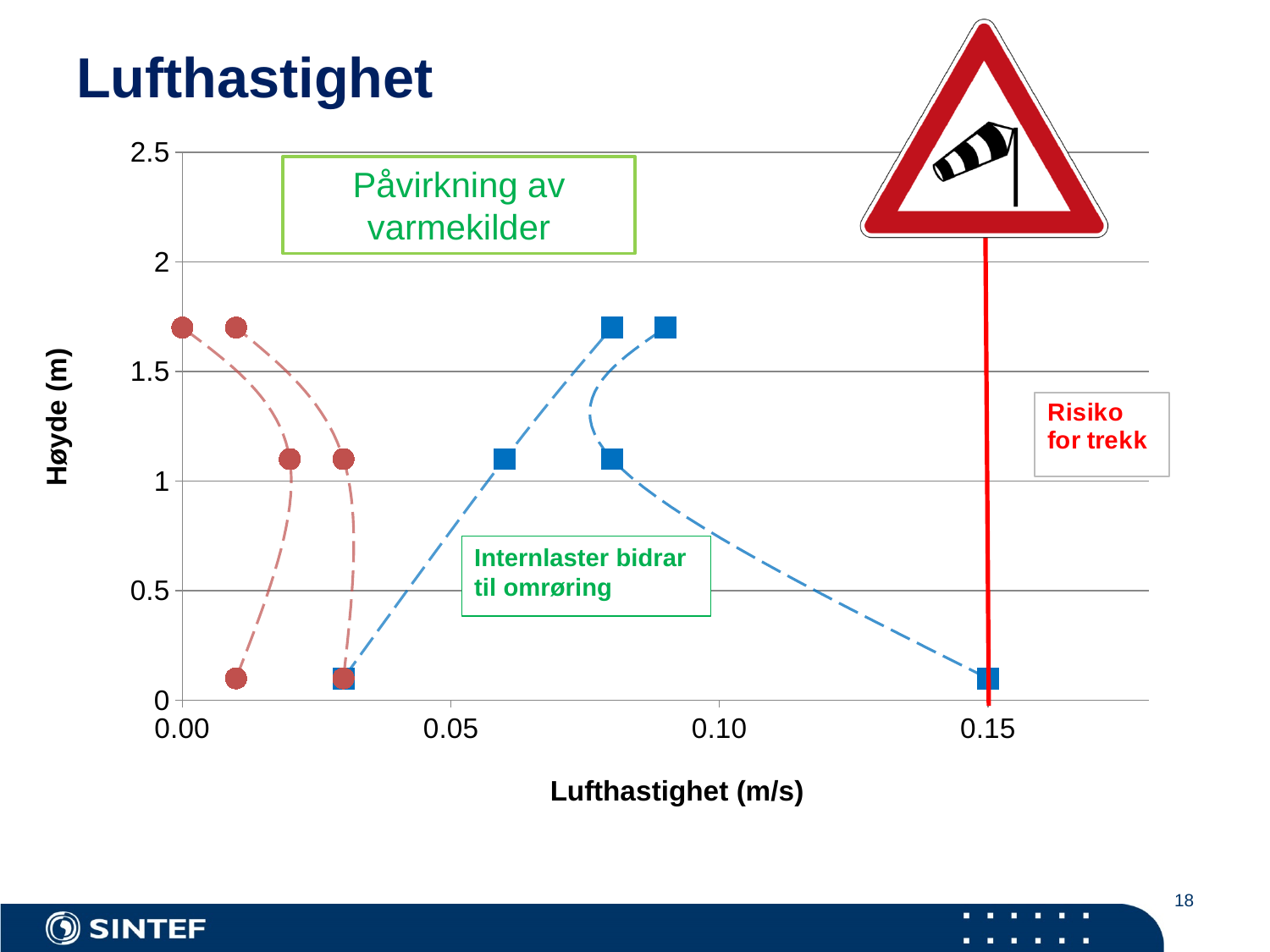
Which marker colour reaches the highest air velocity, red circles or blue squares? blue squares What kind of chart is shown on the slide? scatter chart Is the air velocity of the rightmost blue square marker greater or less than 0.10? greater Is the air velocity of the rightmost red circle marker greater or less than 0.05? less How many red circle markers are plotted on the chart? 6 At the lowest height, is the rightmost blue square at a higher or lower air velocity than the red circles? higher What is the title of the y axis of the chart? Høyde (m) What air velocity does the rightmost blue square marker have? 0.15 How many blue square markers are plotted on the chart? 6 What air velocity does the leftmost red circle marker have? 0.00 What is the title of the x axis of the chart? Lufthastighet (m/s) For the blue series that starts at 0.15 m/s, does air velocity increase or decrease as height increases? decrease